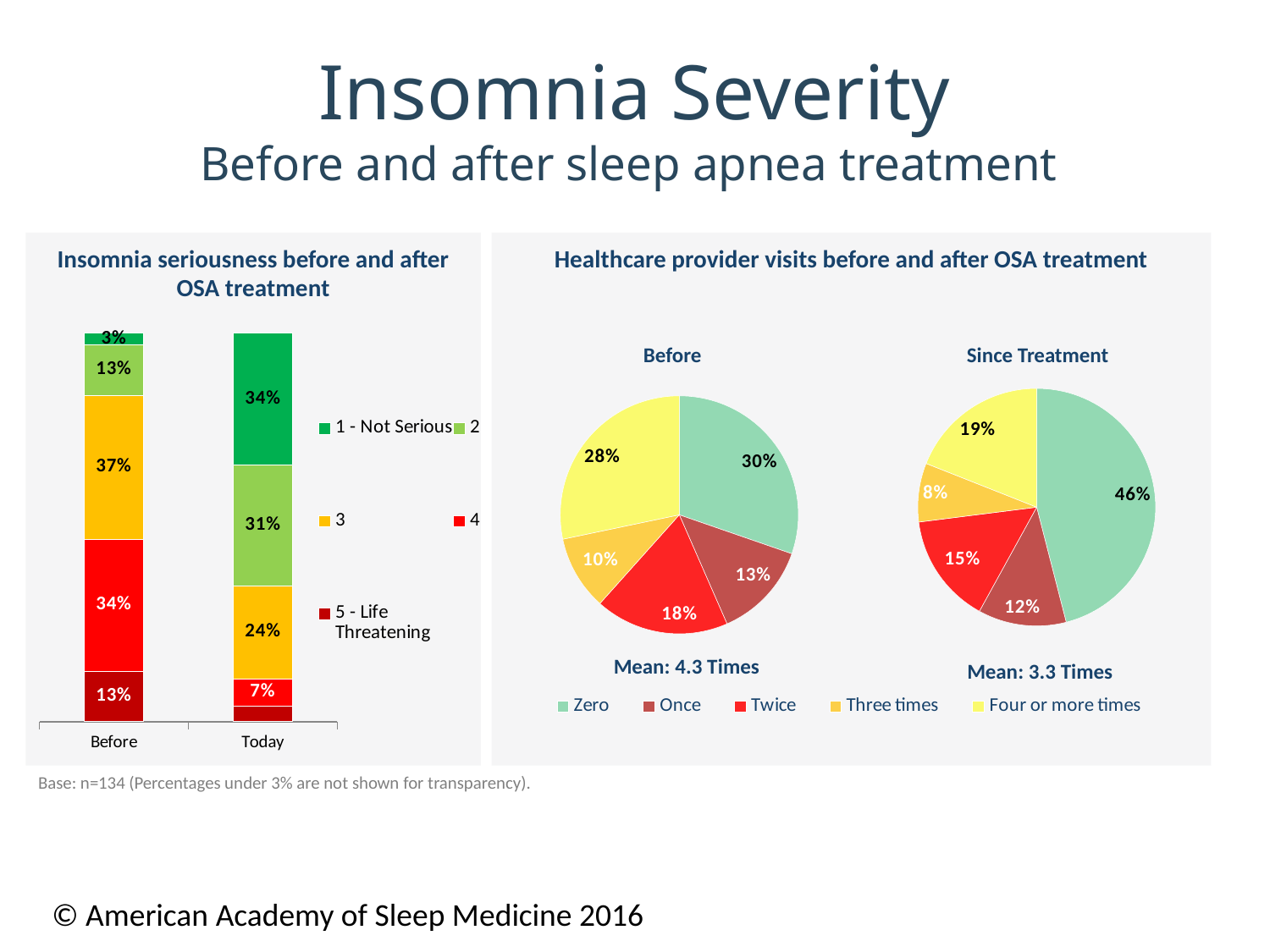
In the 'Healthcare provider visits before and after OSA treatment' Before pie, what share is 'Four or more times'? 28% In the 'Healthcare provider visits before and after OSA treatment' Since Treatment pie, what share is 'Zero'? 46% In the 'Insomnia seriousness before and after OSA treatment' chart, what is the difference between the rating 4 share for Before and for Today? 27% In the 'Healthcare provider visits before and after OSA treatment' charts, is the 'Twice' share larger Before or Since Treatment? Before In the 'Insomnia seriousness before and after OSA treatment' chart, what percentage of the Today bar is '1 - Not Serious'? 34% In the 'Insomnia seriousness before and after OSA treatment' chart, what percentage of the Before bar is '5 - Life Threatening'? 13% What kind of chart is 'Insomnia seriousness before and after OSA treatment'? Stacked bar chart In the 'Insomnia seriousness before and after OSA treatment' chart, how many series does the legend list? 5 In the 'Healthcare provider visits before and after OSA treatment' Before pie, which category has the largest share? Zero In the 'Insomnia seriousness before and after OSA treatment' chart, what percentage of the Before bar is rated 3? 37% In the 'Healthcare provider visits before and after OSA treatment' Since Treatment pie, which category has the smallest share? Three times What is the mean number of healthcare provider visits shown for the Since Treatment pie? 3.3 Times